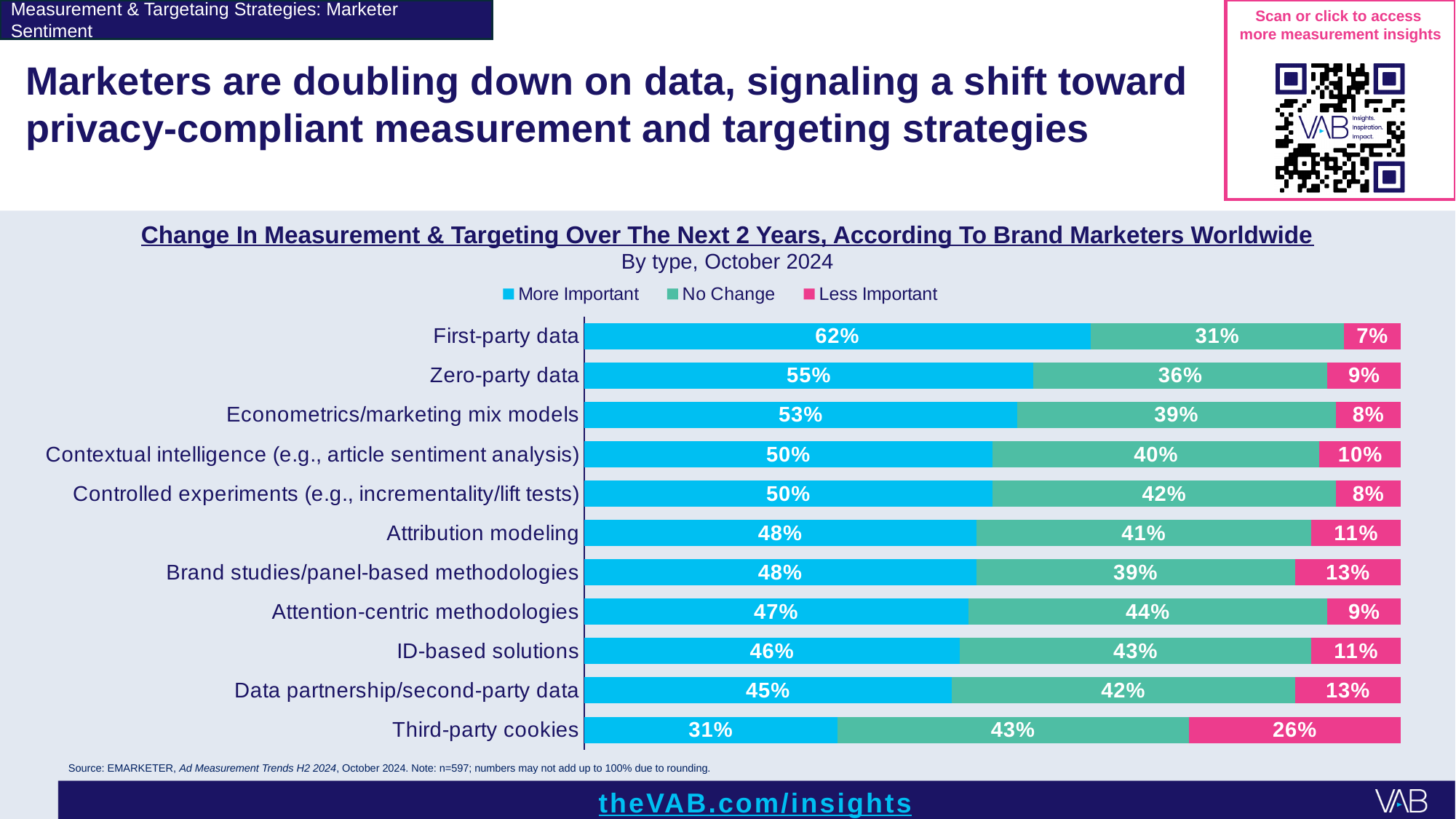
Which category has the highest 'More Important' share? First-party data Which category has the lowest 'More Important' share? Third-party cookies Which has a larger 'No Change' share: econometrics/marketing mix models or attention-centric methodologies? Attention-centric methodologies What is the 'Less Important' value for third-party cookies? 26% What percentage of brand marketers say first-party data will become more important? 62% What is the 'No Change' value for attention-centric methodologies? 44% What is the difference between the 'More Important' values for first-party data and zero-party data? 7% What kind of chart is shown on the slide? Stacked bar chart How many series does the legend list? 3 How many categories are shown in the chart? 11 Which category has the highest 'Less Important' share? Third-party cookies What is the total of the three segments for the ID-based solutions bar? 100%